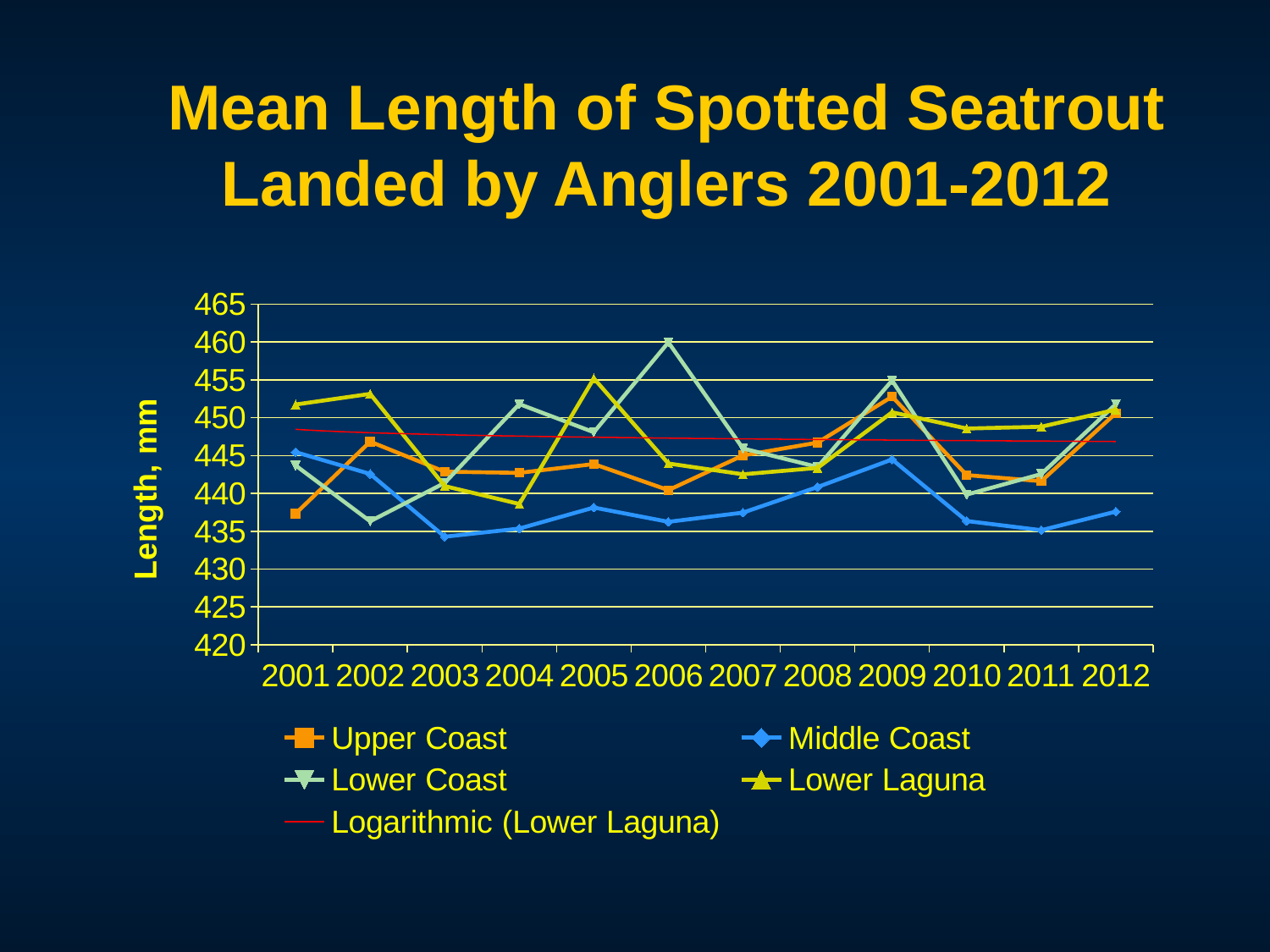
In which year does the Upper Coast series have its lowest value? 2001 In 2006, which is larger: Lower Coast or Middle Coast? Lower Coast Is the value for Upper Coast in 2001 greater or less than 440? less What type of chart is shown on the slide? line chart How many entries does the legend list? 5 How many years are plotted along the x axis? 12 Which series has the highest value in 2001? Lower Laguna In which year does the Lower Coast series reach its highest value? 2006 Is the value for Lower Laguna in 2005 greater or less than 450? greater Is the value for Lower Coast in 2006 greater or less than 455? greater What is the label of the y axis? Length, mm